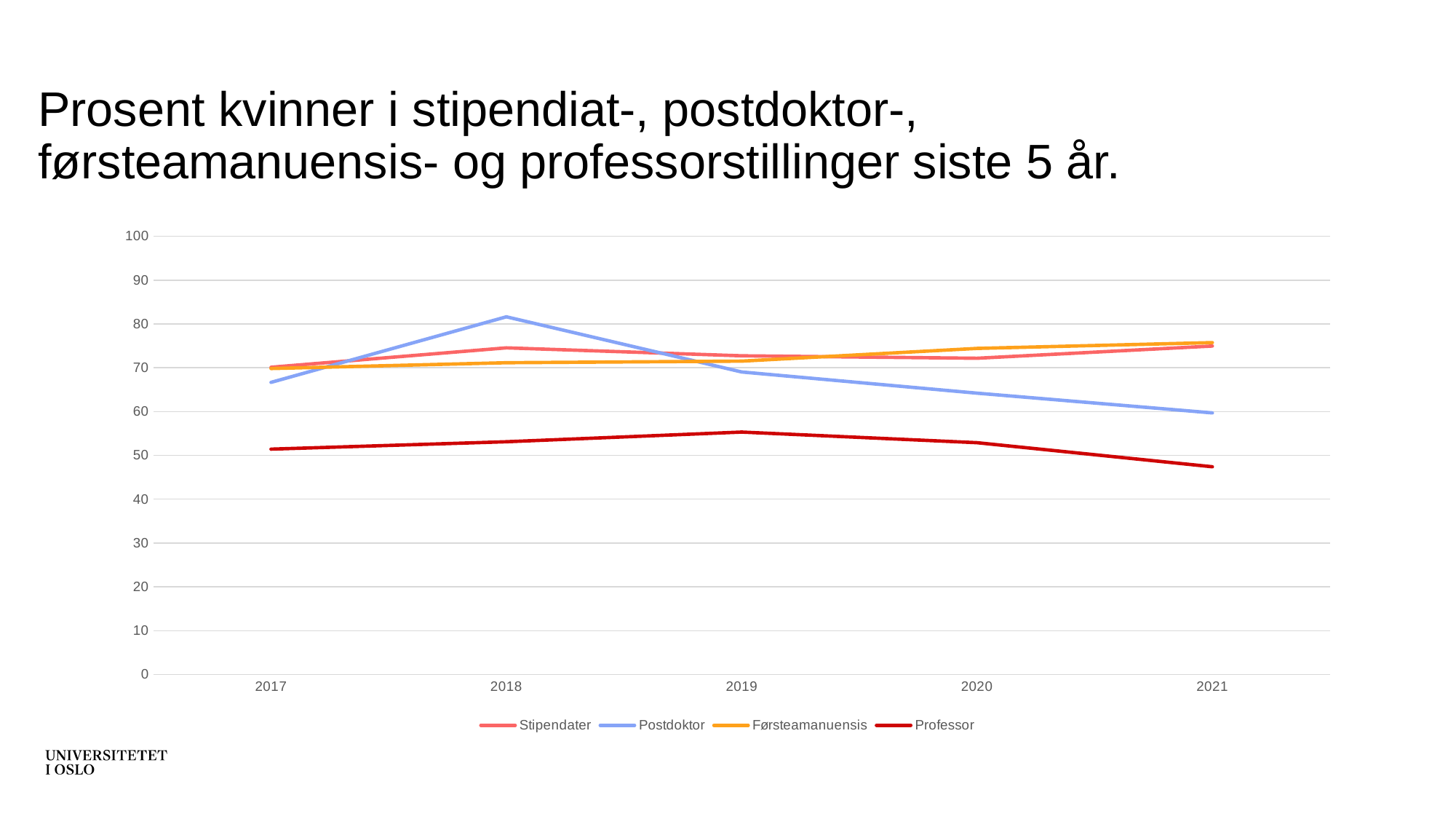
Is the value for Professor in 2021 greater or less than 50? less Which series has the lowest value in 2021? Professor Which is larger in 2021, the value for Postdoktor or the value for Professor? Postdoktor What kind of chart is shown on the slide? line chart How many series does the legend list? 4 Which series has the highest value in 2018? Postdoktor Is the value for Postdoktor in 2018 greater or less than 80? greater How many years are shown along the x axis? 5 Is the value for Professor in 2019 greater or less than 50? greater Does the Postdoktor line rise or fall from 2018 to 2021? fall What colour is the Professor line in the legend? dark red Which series has the lowest value in 2017? Professor